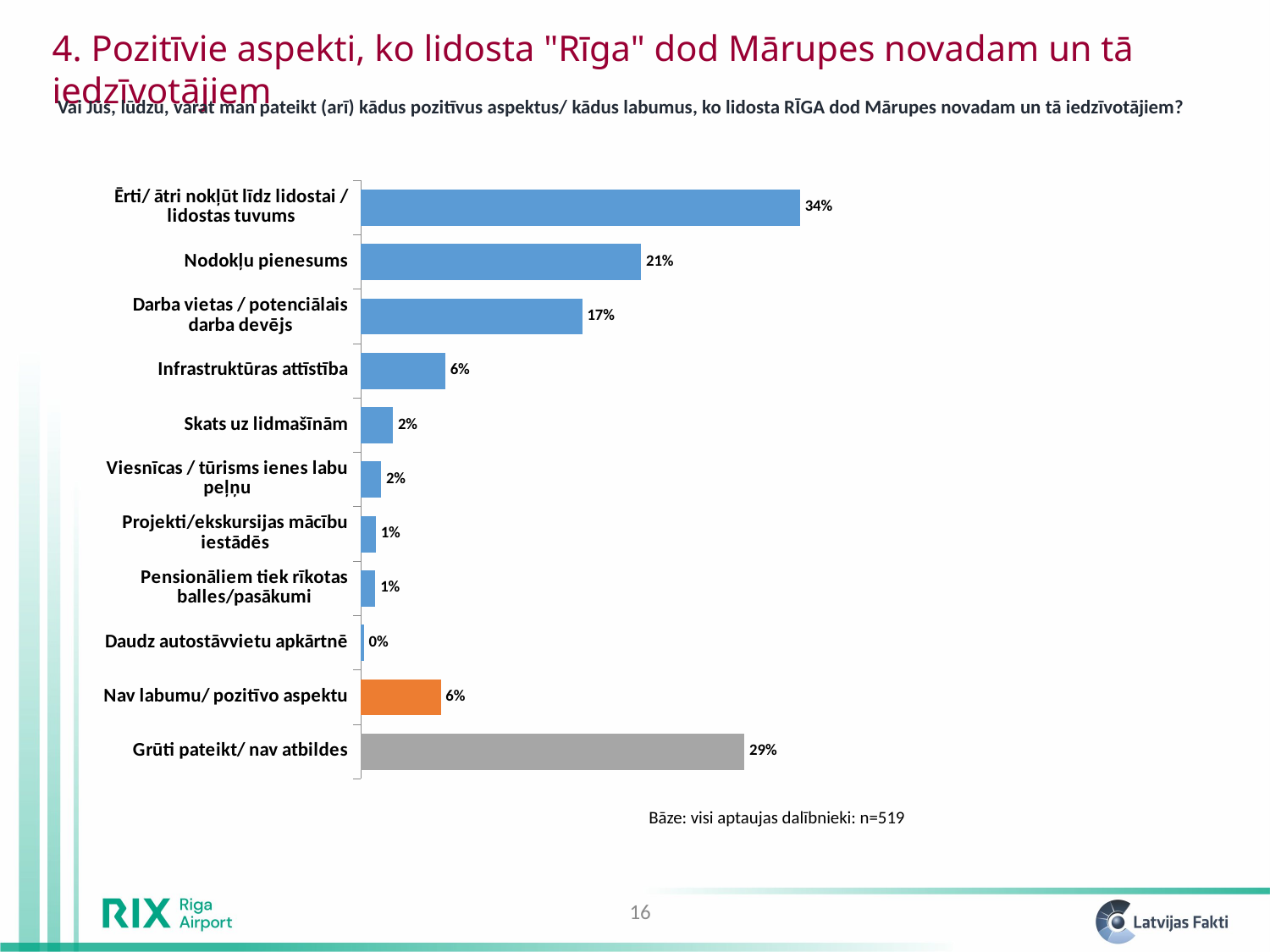
What is the value for "Nav labumu/ pozitīvo aspektu"? 6% Which category has the highest value? Ērti/ ātri nokļūt līdz lidostai / lidostas tuvums Which is larger: the value for "Grūti pateikt/ nav atbildes" or the value for "Nodokļu pienesums"? Grūti pateikt/ nav atbildes What is the difference between the values for "Infrastruktūras attīstība" and "Skats uz lidmašīnām"? 4% What kind of chart is shown on the slide? Bar chart What is the value for "Nodokļu pienesums"? 21% What is the difference between the values for "Ērti/ ātri nokļūt līdz lidostai / lidostas tuvums" and "Nodokļu pienesums"? 13% What is the value for "Grūti pateikt/ nav atbildes"? 29% What is the value for "Darba vietas / potenciālais darba devējs"? 17% How many categories are shown in the chart? 11 Which category has the lowest value? Daudz autostāvvietu apkārtnē What colour is the bar for "Nav labumu/ pozitīvo aspektu"? Orange